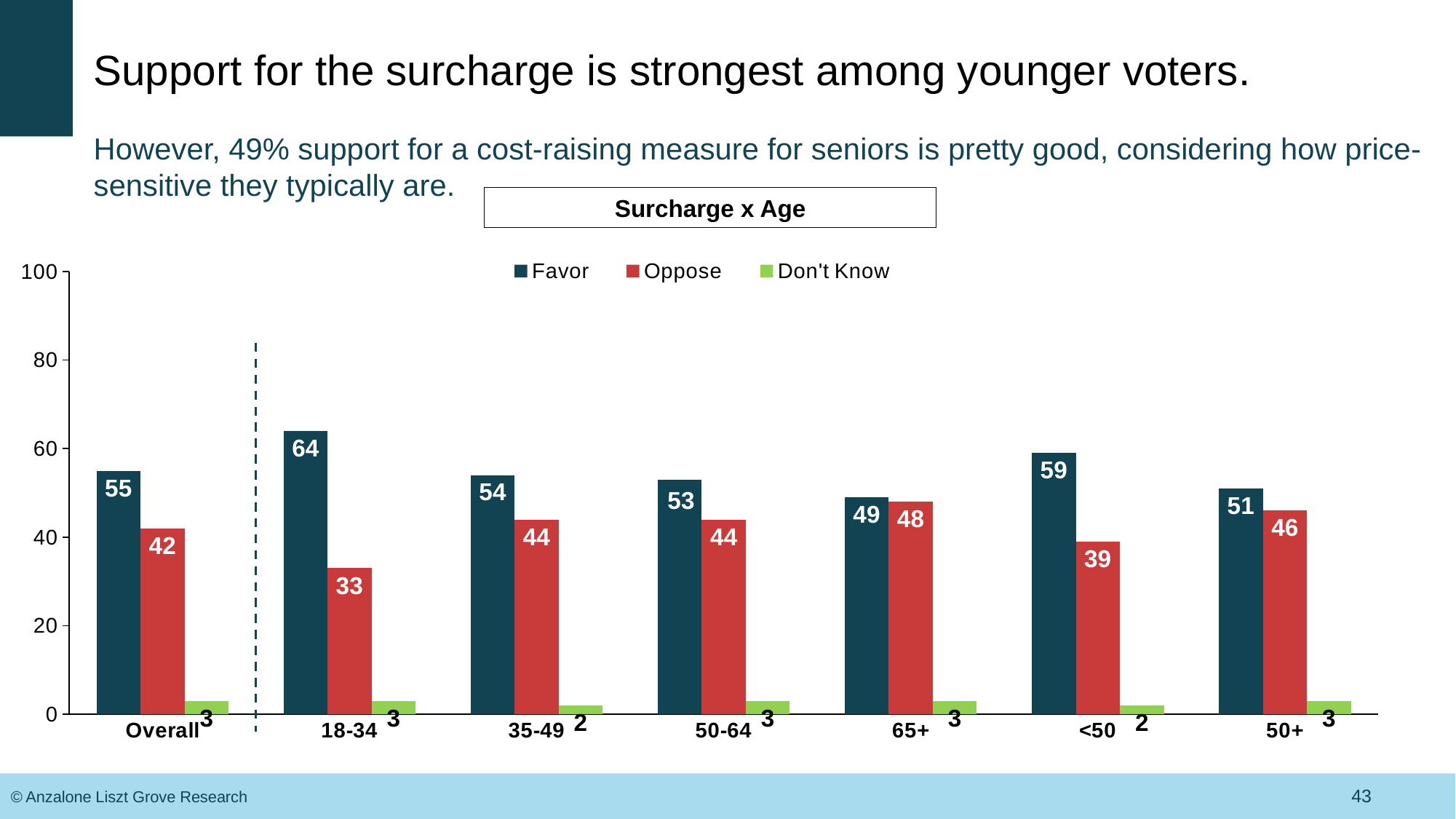
What is the difference between the Favor and Oppose values for the <50 group? 20 What kind of chart is shown on the slide? bar chart Which age category has the highest Favor value? 18-34 Is the Favor value for 18-34 greater or less than 60? greater How many series does the legend list? 3 What is the Don't Know value for the 35-49 age group? 2 What is the Favor value for the 18-34 age group? 64 What is the title of the chart? Surcharge x Age Which category has the lowest Oppose value? 18-34 Is the Favor value larger for 50-64 or for 65+? 50-64 What is the Oppose value for the 65+ age group? 48 How many categories are shown on the x axis? 7